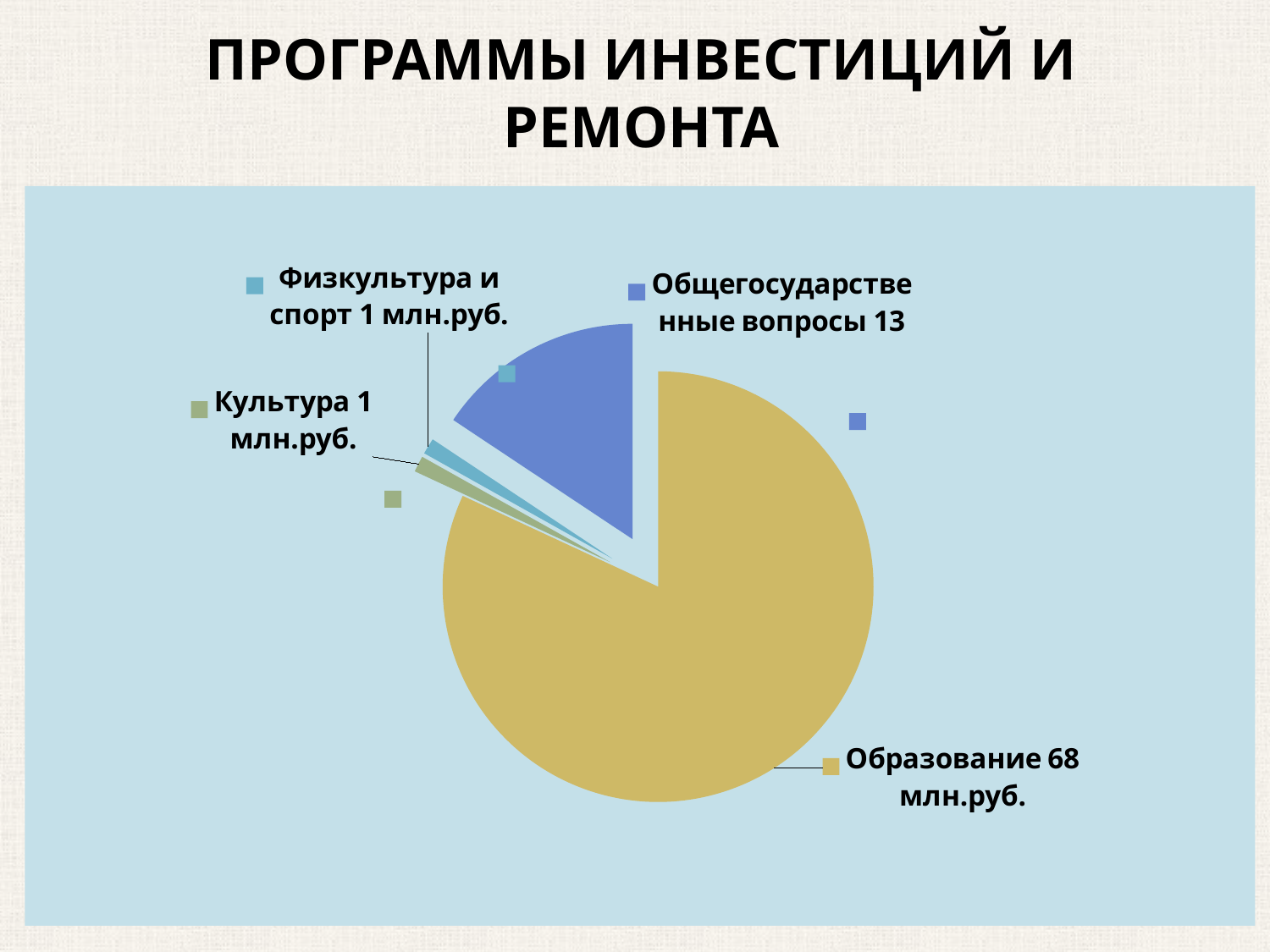
What is the value for Физкультура и спорт? 1 млн.руб. What is the difference between the values for Образование and Общегосударственные вопросы? 55 Which is larger, the value for Общегосударственные вопросы or the value for Культура? Общегосударственные вопросы Which category has the largest slice of the pie? Образование How many slices does the pie chart have? 4 What is the value for Культура? 1 млн.руб. What is the value for Общегосударственные вопросы? 13 What kind of chart is shown on the slide? pie chart What colour is the slice for Образование? yellow (gold) What is the value for Образование? 68 млн.руб. What is the title of the slide containing the pie chart? ПРОГРАММЫ ИНВЕСТИЦИЙ И РЕМОНТА What is the total of all the slices in the pie chart? 83